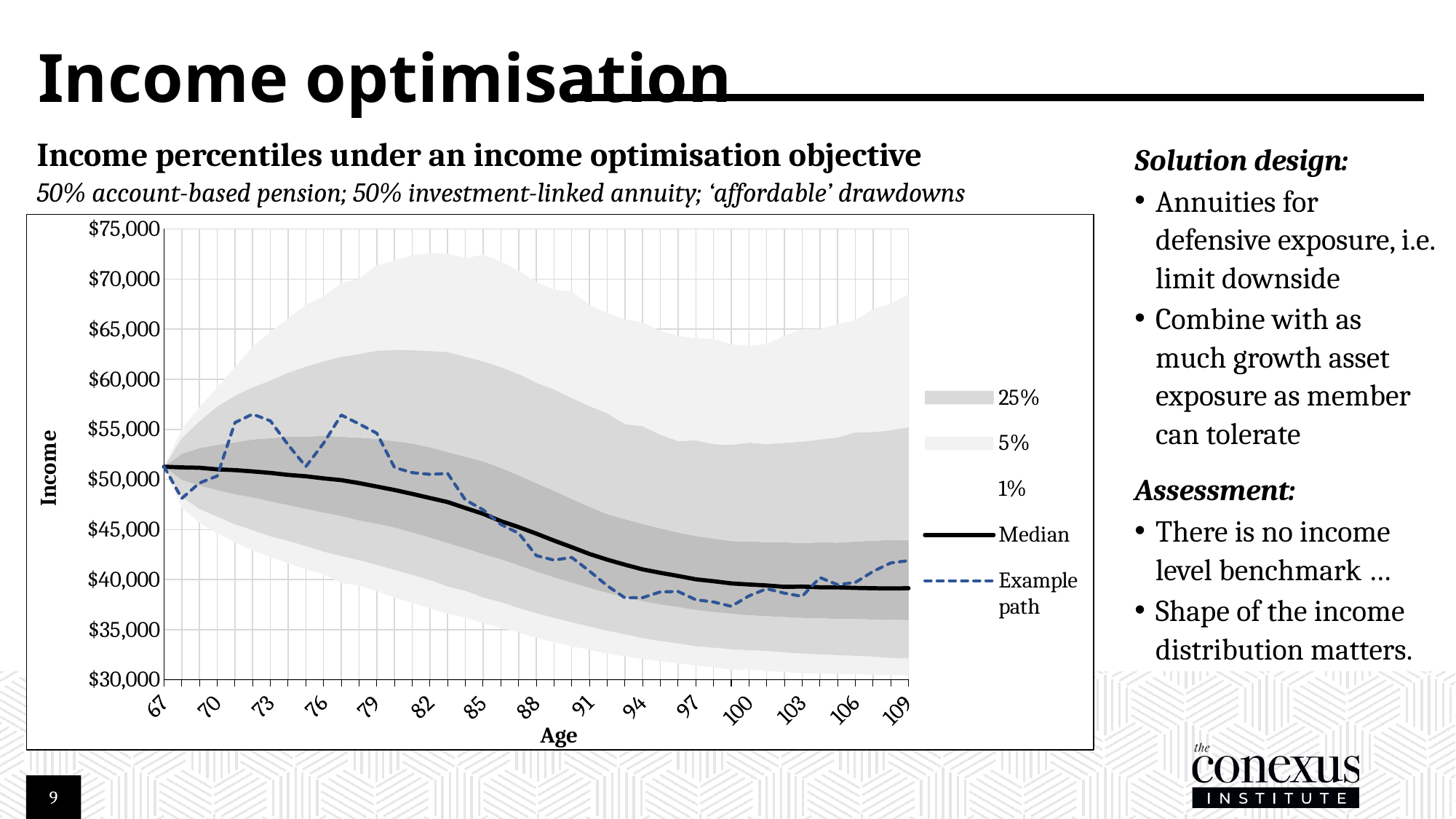
What is the title of the chart's x axis? Age Which is larger, the Example path value at age 73 or at age 94? age 73 Is the Example path value at age 100 greater or less than $40,000? less How many entries does the chart's legend list? 5 Is the Median value at age 85 greater or less than $50,000? less Is the Example path value at age 73 greater or less than $55,000? greater What kind of chart is shown on the slide? combination area and line chart Which is larger, the Median value at age 67 or the Median value at age 109? age 67 How many age tick labels are shown on the x axis? 15 Which legend entry is drawn as a dashed blue line? Example path Does the Median line rise or fall as age increases from 67 to 109? fall